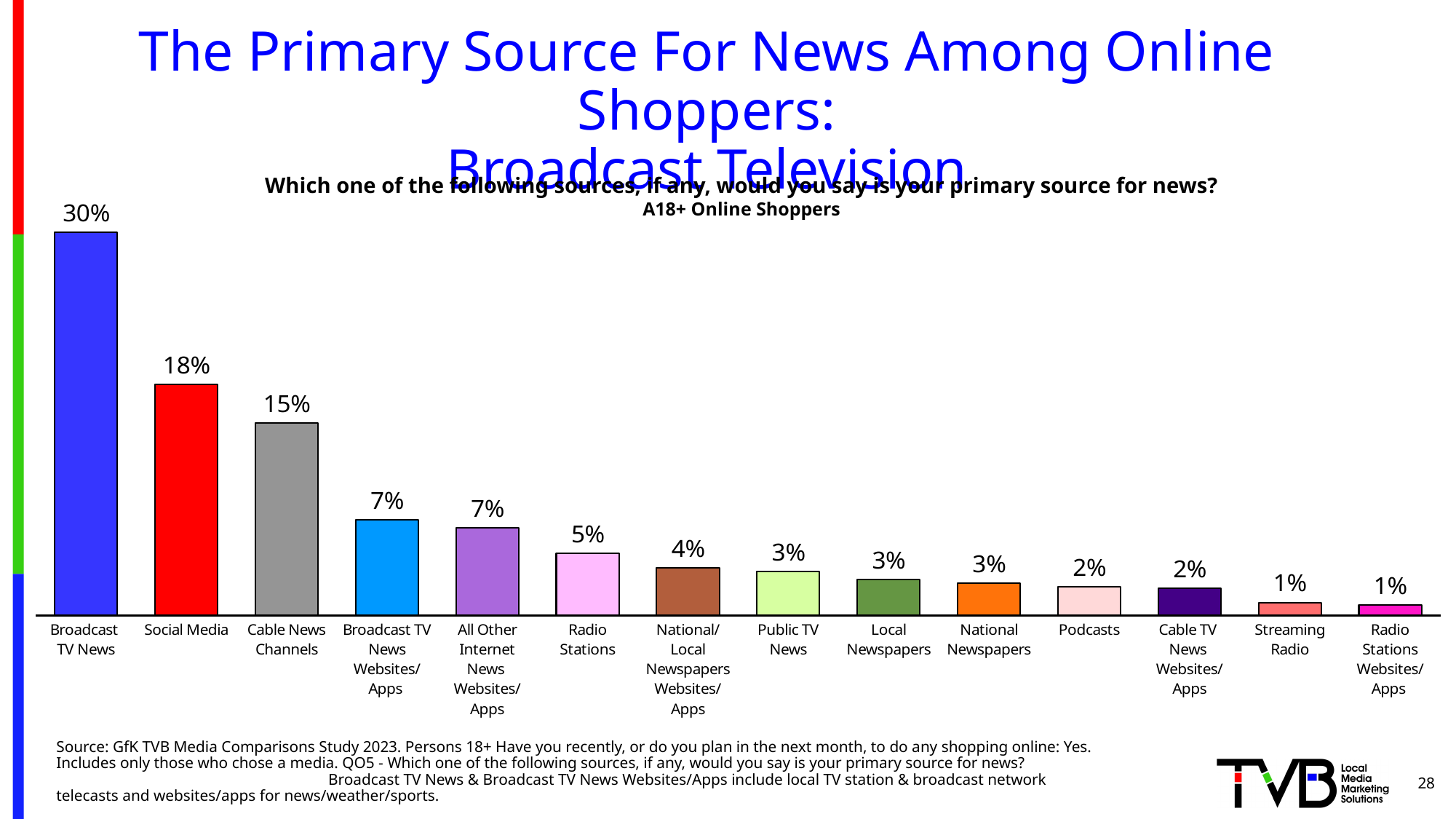
Do the values rise or fall moving from left to right across the chart? Fall Which is larger, the value for Social Media or the value for Cable News Channels? Social Media What percentage of A18+ online shoppers say Broadcast TV News is their primary source for news? 30% How many news sources (categories) are shown in the chart? 14 Which source has the highest percentage in the chart? Broadcast TV News What is the value shown for Podcasts? 2% What is the value shown for Radio Stations? 5% What is the difference between the values for Broadcast TV News and Social Media? 12% What kind of chart is shown on the slide? Bar chart What is the difference between the values for Cable News Channels and Radio Stations? 10% What is the value shown for Social Media? 18% What is the value shown for Cable News Channels? 15%